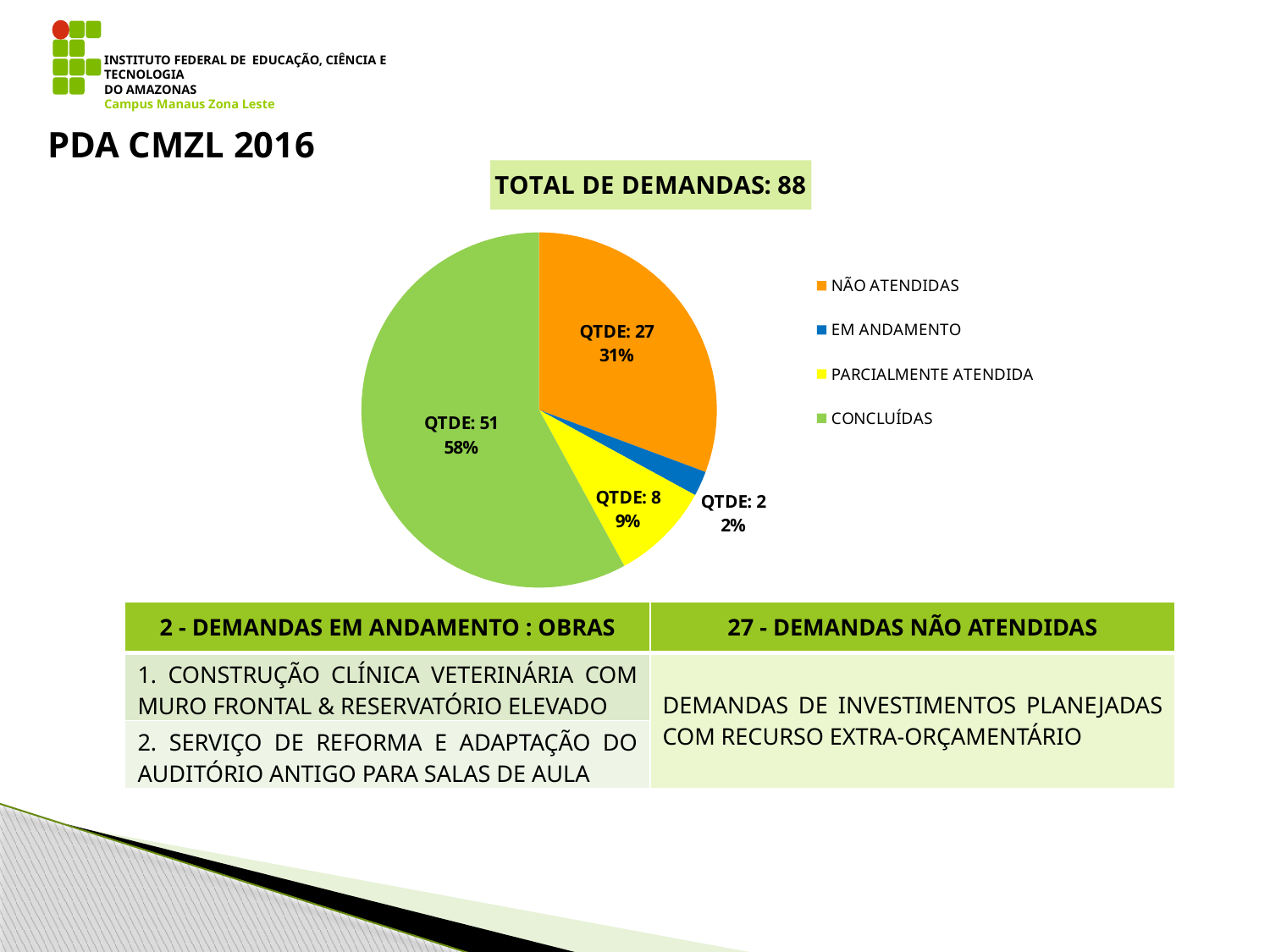
What colour is the slice for NÃO ATENDIDAS in the pie chart? Orange Which has a larger quantity, PARCIALMENTE ATENDIDA or EM ANDAMENTO? PARCIALMENTE ATENDIDA How many slices does the pie chart have? 4 What percentage share does EM ANDAMENTO have in the pie chart? 2% What is the quantity (QTDE) for CONCLUÍDAS in the pie chart? 51 Which category has the smallest slice in the pie chart? EM ANDAMENTO What is the difference in quantity between CONCLUÍDAS and NÃO ATENDIDAS? 24 What is the quantity (QTDE) for PARCIALMENTE ATENDIDA? 8 Which category has the largest slice in the pie chart? CONCLUÍDAS What kind of chart is shown on the slide? Pie chart What percentage of the pie does NÃO ATENDIDAS represent? 31% How many entries does the legend of the pie chart list? 4